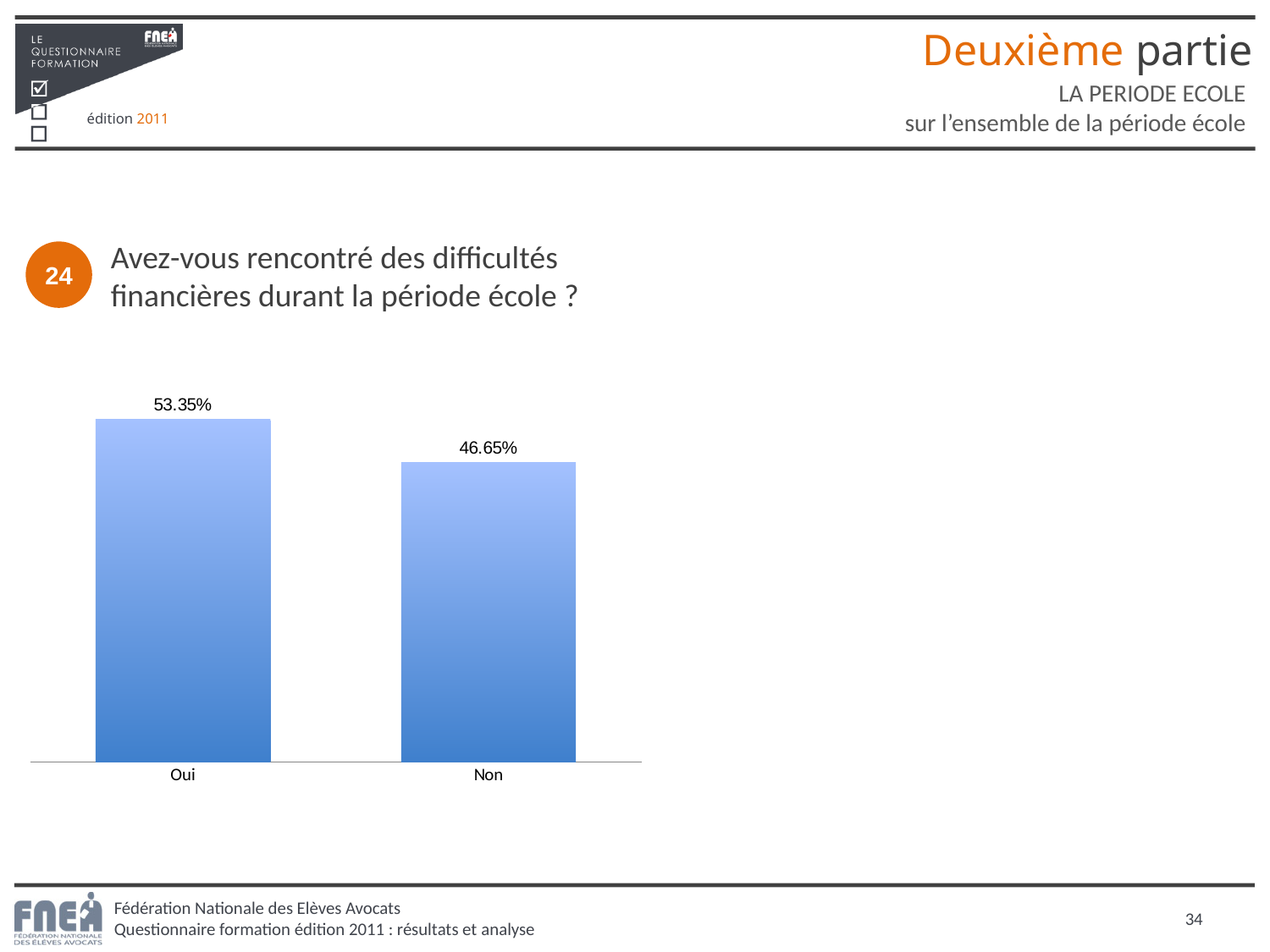
What is the question number shown next to the chart's question? 24 What is the value for Non? 46.65% What kind of chart is shown on the slide? bar chart Which is larger, the value for Oui or the value for Non? Oui Which category has the highest value? Oui What question does the chart answer, according to the slide? Avez-vous rencontré des difficultés financières durant la période école ? How many categories are shown in the chart? 2 What is the value for Oui? 53.35% What is the total of the two values shown in the chart? 100% Which category has the lowest value? Non What is the difference between the values for Oui and Non? 6.70%